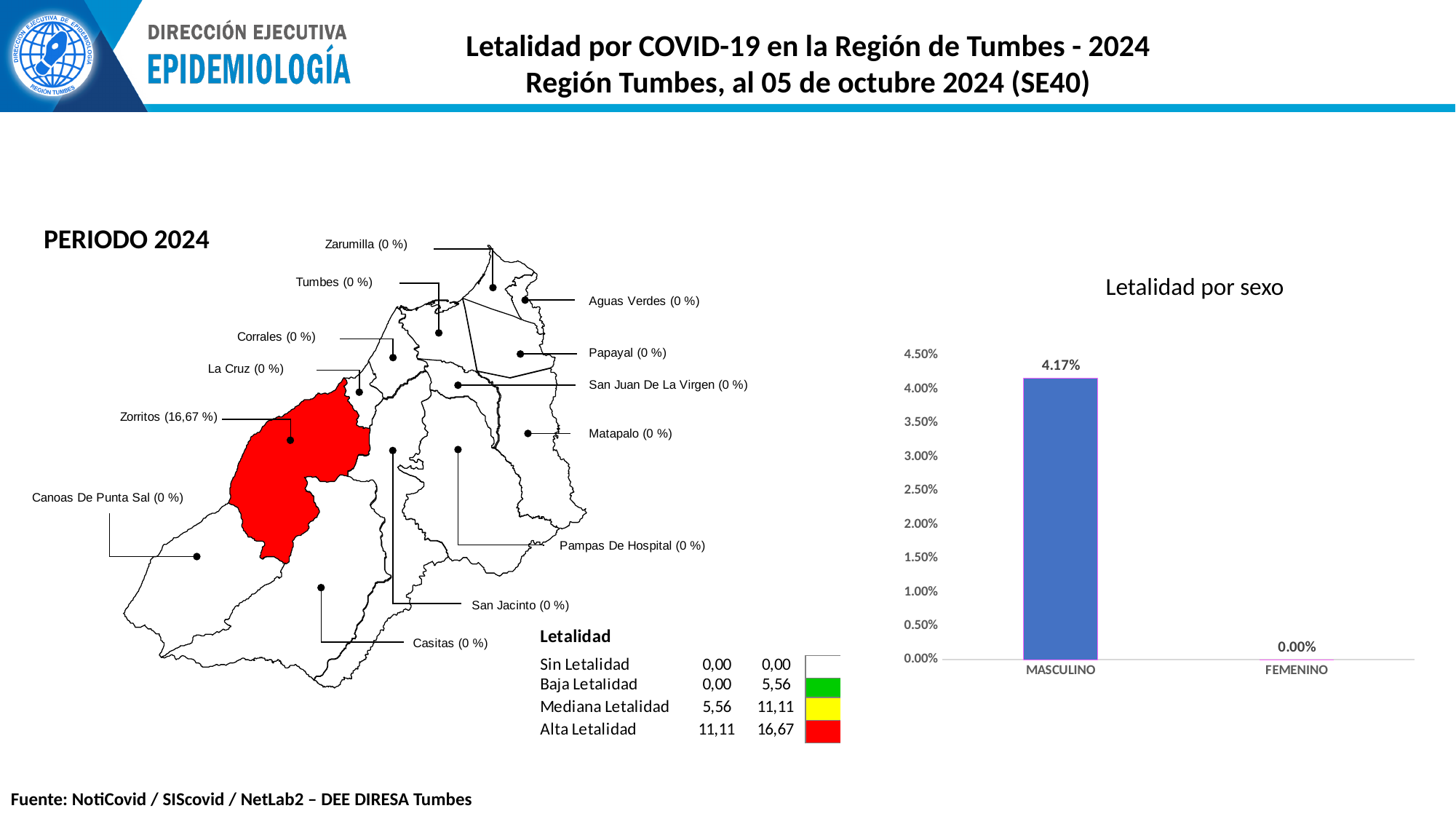
In the 'Letalidad por sexo' chart, which category has the lowest value? FEMENINO In the 'Letalidad por sexo' chart, what is the value for FEMENINO? 0.00% In the 'Letalidad por sexo' chart, which is larger, the value for MASCULINO or for FEMENINO? MASCULINO How many categories are shown in the 'Letalidad por sexo' chart? 2 What kind of chart is 'Letalidad por sexo'? bar chart In the 'Letalidad por sexo' chart, what is the difference between the MASCULINO and FEMENINO values? 4.17% What is the highest value shown on the y axis of the 'Letalidad por sexo' chart? 4.50% In the 'Letalidad por sexo' chart, is the value for MASCULINO greater or less than 4.00%? greater In the 'Letalidad por sexo' chart, which category has the highest value? MASCULINO On the map on the left, what is the lethality value shown for Zorritos? 16,67 % In the 'Letalidad por sexo' chart, what is the value for MASCULINO? 4.17% On the map on the left, which district is shaded red? Zorritos